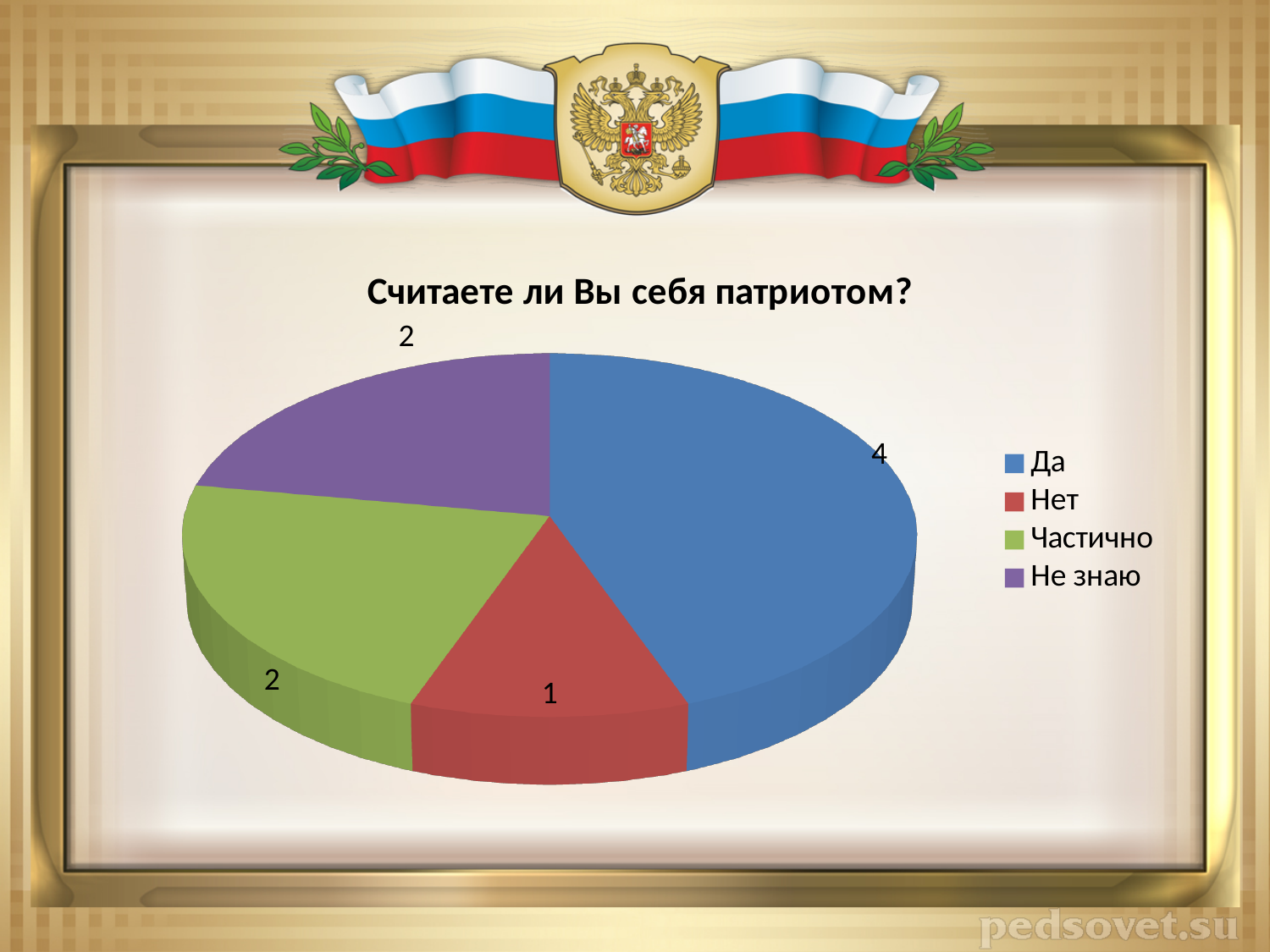
What is the value for the "Нет" slice? 1 Which category has the smallest slice? Нет What colour is the "Не знаю" slice? purple What kind of chart is shown on the slide? pie chart Which category has the largest slice? Да What is the value for the "Да" slice? 4 What is the difference between the values for "Да" and "Нет"? 3 How many categories does the legend list? 4 What is the value for the "Не знаю" slice? 2 Which is larger, the value for "Да" or the value for "Частично"? Да What is the value for the "Частично" slice? 2 What is the title of the chart? Считаете ли Вы себя патриотом?